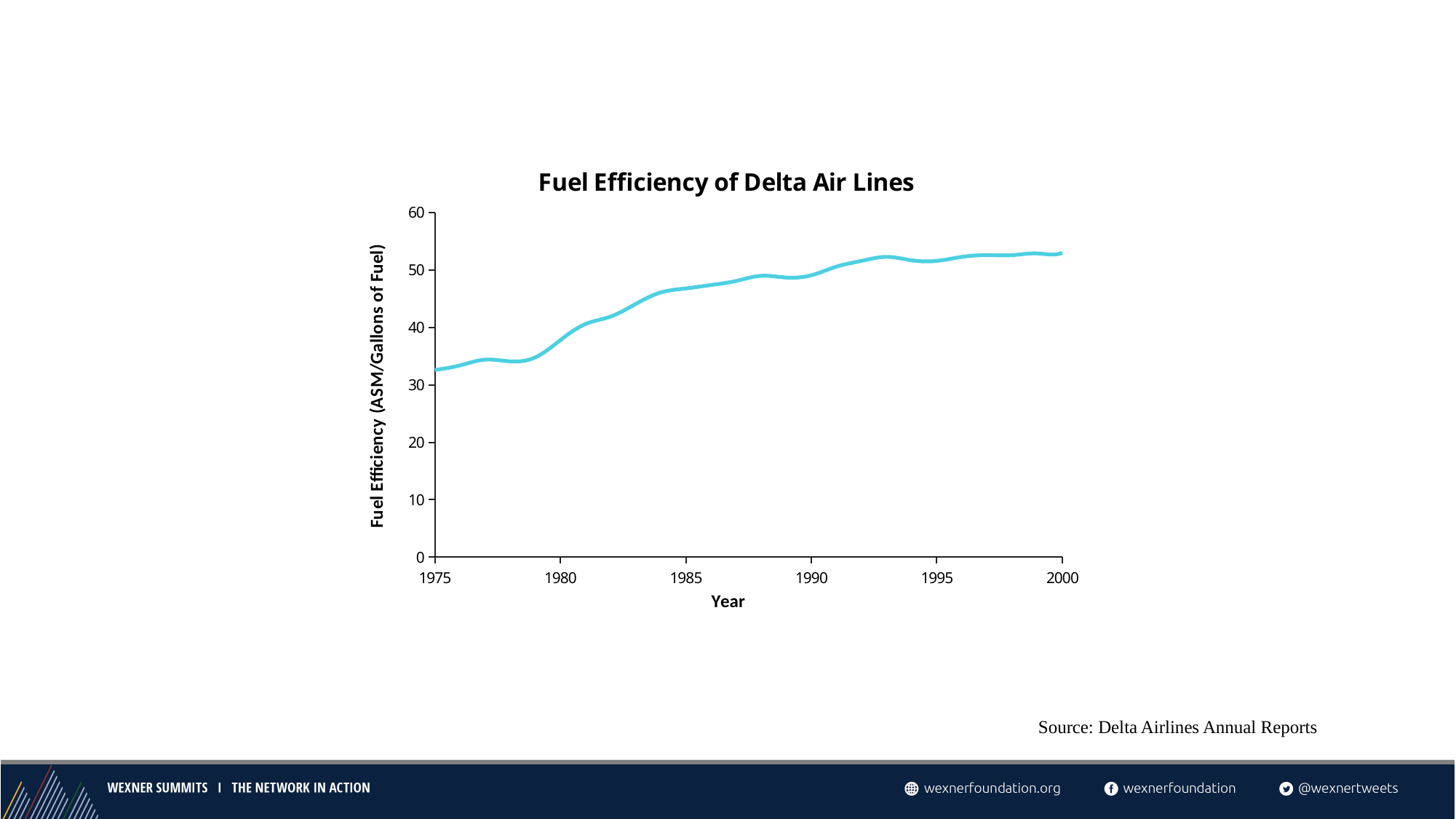
Which year has the lowest fuel efficiency on the chart? 1975 Is the value for 1975 greater or less than 30? greater Which is larger, the value for 1980 or the value for 1985? 1985 What is the title of the chart? Fuel Efficiency of Delta Air Lines Is the value for 1975 greater or less than 40? less What kind of chart is shown on the slide? line chart Does fuel efficiency generally rise or fall from 1975 to 2000? rise Is the value for 1985 greater or less than 40? greater What is the label of the y axis? Fuel Efficiency (ASM/Gallons of Fuel) Which is larger, the value for 1975 or the value for 2000? 2000